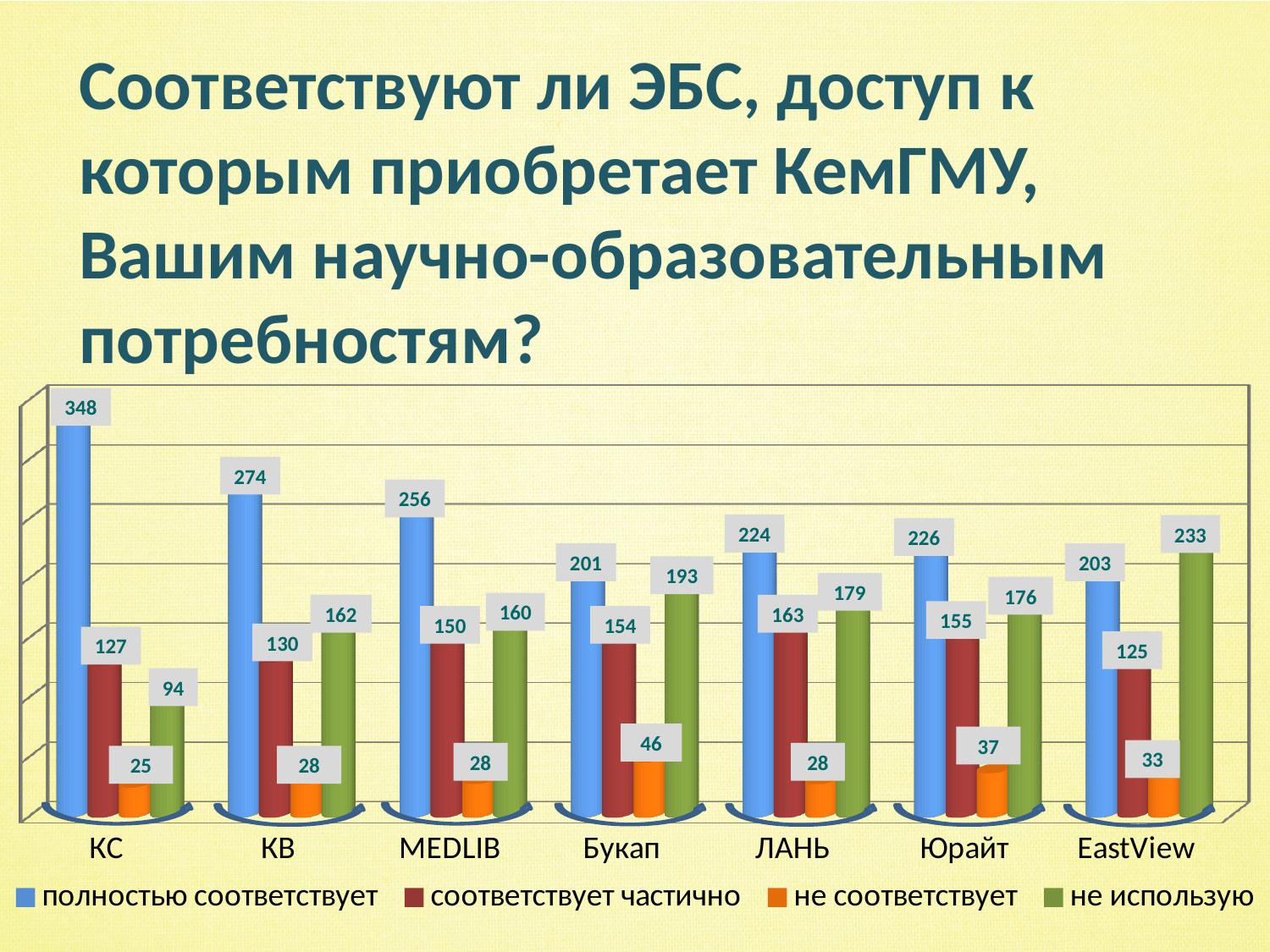
What kind of chart is shown on the slide? bar chart What is the value of 'соответствует частично' for Юрайт? 155 Which category has the highest value for 'полностью соответствует'? КС Which is larger for ЛАНЬ: 'соответствует частично' or 'не использую'? не использую What is the value of 'не соответствует' for Букап? 46 Which category has the lowest value for 'не использую'? КС What is the value of 'полностью соответствует' for КС? 348 How many series does the legend list? 4 What is the value of 'не использую' for EastView? 233 How many categories are shown on the x axis? 7 What is the difference between 'полностью соответствует' for КС and for КВ? 74 Which series is shown in green in the legend? не использую